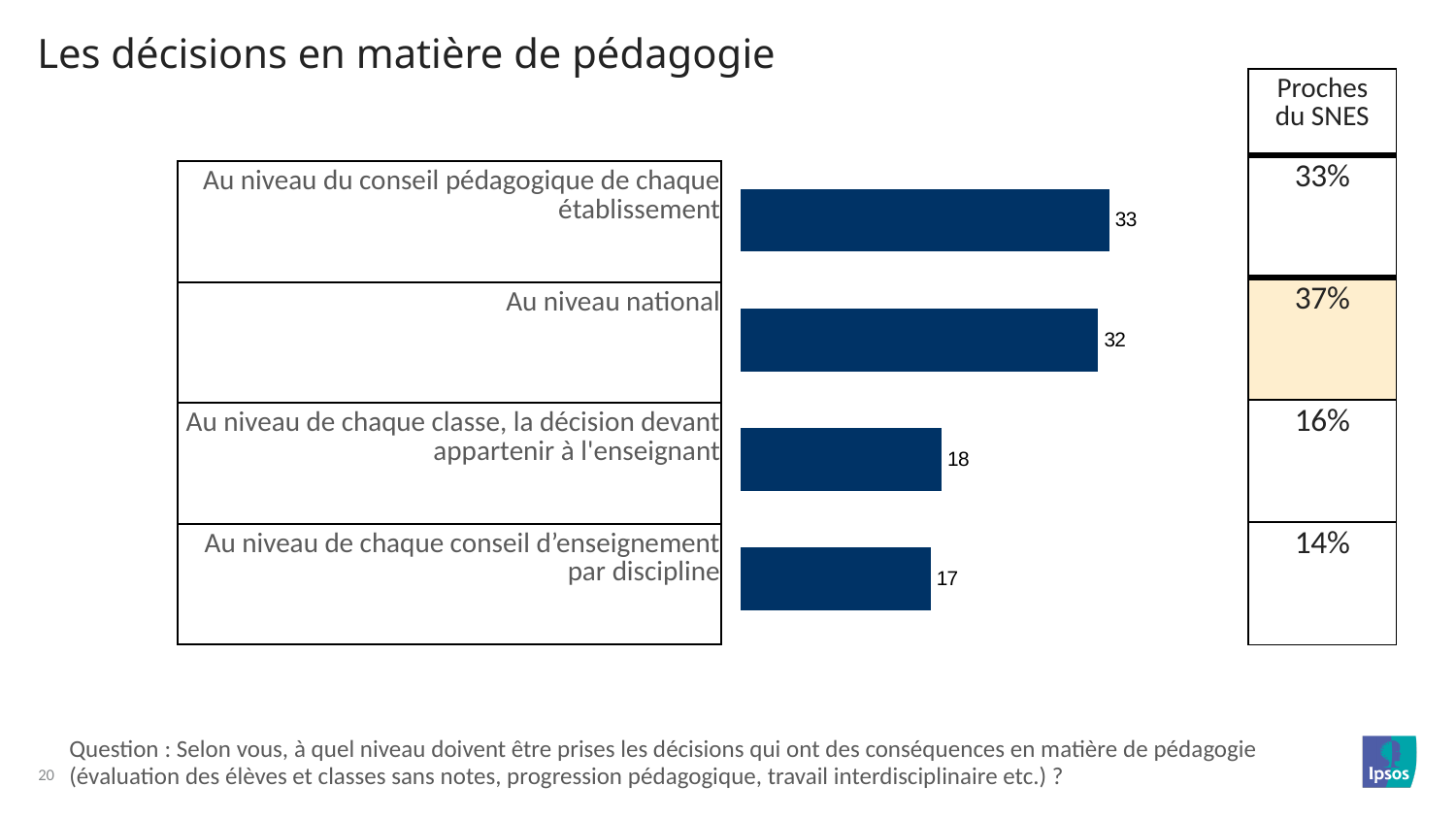
What kind of chart is shown on the slide? Bar chart How many categories are shown in the chart? 4 Which category has the highest value? Au niveau du conseil pédagogique de chaque établissement What is the value for "Au niveau de chaque conseil d'enseignement par discipline"? 17 Which is larger: the value for "Au niveau national" or the value for "Au niveau de chaque classe, la décision devant appartenir à l'enseignant"? Au niveau national Which category has the lowest value? Au niveau de chaque conseil d'enseignement par discipline What is the value for "Au niveau de chaque classe, la décision devant appartenir à l'enseignant"? 18 What is the value for "Au niveau national"? 32 What is the difference between the values for "Au niveau national" and "Au niveau de chaque conseil d'enseignement par discipline"? 15 What is the difference between the values for "Au niveau du conseil pédagogique de chaque établissement" and "Au niveau de chaque classe, la décision devant appartenir à l'enseignant"? 15 What is the value for "Au niveau du conseil pédagogique de chaque établissement"? 33 What is the title of the slide containing the chart? Les décisions en matière de pédagogie